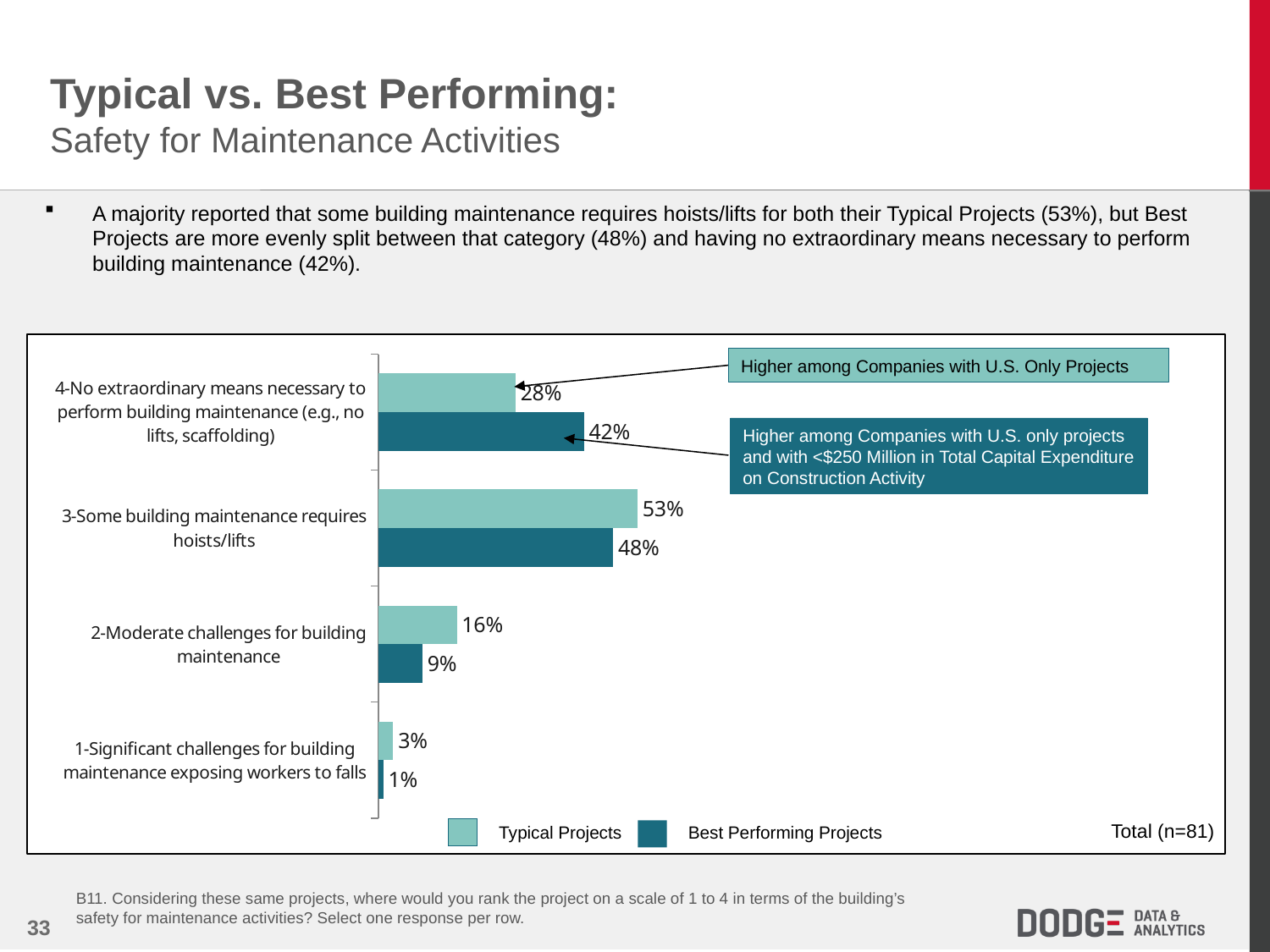
What is the total sample size (n) shown on the chart? 81 What is the value for Typical Projects in the category '1-Significant challenges for building maintenance exposing workers to falls'? 3% What is the value for Best Performing Projects in the category '2-Moderate challenges for building maintenance'? 9% Which category has the lowest value for Best Performing Projects? 1-Significant challenges for building maintenance exposing workers to falls Which category has the highest value for Typical Projects? 3-Some building maintenance requires hoists/lifts What is the value for Best Performing Projects in the category '4-No extraordinary means necessary to perform building maintenance'? 42% What is the difference between Typical Projects and Best Performing Projects in the category '4-No extraordinary means necessary to perform building maintenance'? 14% How many series does the legend list? 2 What kind of chart is shown on the slide? Bar chart How many categories are shown on the chart? 4 What is the value for Typical Projects in the category '3-Some building maintenance requires hoists/lifts'? 53% In the category '2-Moderate challenges for building maintenance', which series has the larger value, Typical Projects or Best Performing Projects? Typical Projects